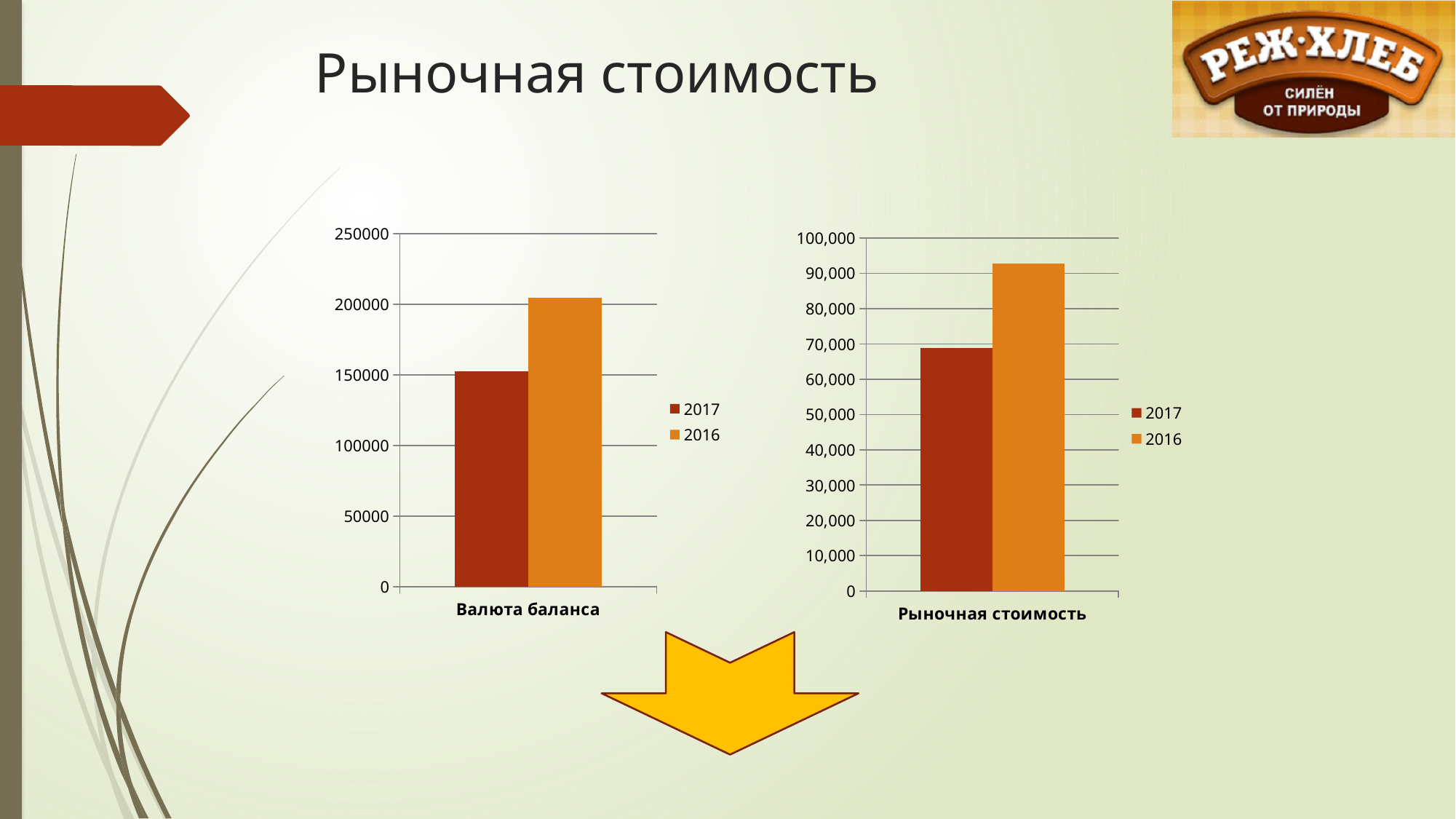
In the left chart (Валюта баланса), is the value for 2016 greater or less than 200000? greater In the right chart (Рыночная стоимость), what is the highest value shown on the vertical axis? 100,000 In the right chart (Рыночная стоимость), is the value for 2016 greater or less than 100,000? less In the right chart (Рыночная стоимость), is the value for 2017 greater or less than 60,000? greater In the left chart (Валюта баланса), how many series does the legend list? 2 What kind of chart is the right chart (Рыночная стоимость)? bar chart In the left chart (Валюта баланса), which series has the taller bar, 2017 or 2016? 2016 What kind of chart is the left chart (Валюта баланса)? bar chart In the right chart (Рыночная стоимость), how many series does the legend list? 2 In the left chart (Валюта баланса), what colour is the bar for 2016? orange In the right chart (Рыночная стоимость), which series has the taller bar, 2017 or 2016? 2016